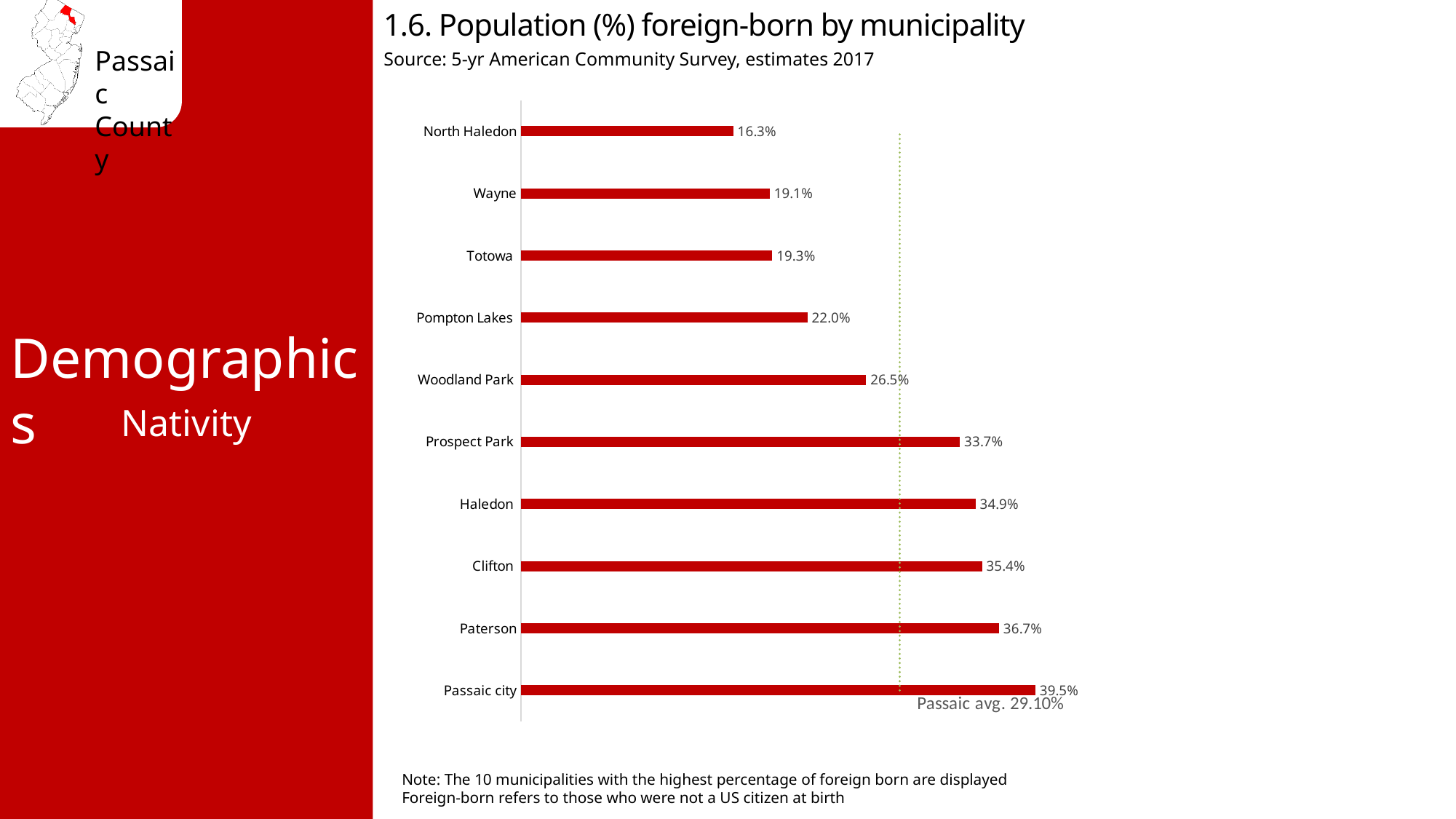
What is the source of the data shown in the chart? 5-yr American Community Survey, estimates 2017 What is the Passaic average foreign-born percentage marked by the dotted line? 29.10% What is the difference in foreign-born percentage between Passaic city and North Haledon? 23.2 percentage points Which has a higher foreign-born percentage, Pompton Lakes or Haledon? Haledon What is the foreign-born population percentage for Passaic city? 39.5% What is the difference in foreign-born percentage between Paterson and Clifton? 1.3 percentage points What kind of chart is shown on the slide? Bar chart Which municipality has the highest percentage of foreign-born population? Passaic city What is the foreign-born population percentage for Wayne? 19.1% How many municipalities are shown in the chart? 10 Which municipality has the lowest percentage of foreign-born population? North Haledon What is the foreign-born population percentage for Woodland Park? 26.5%